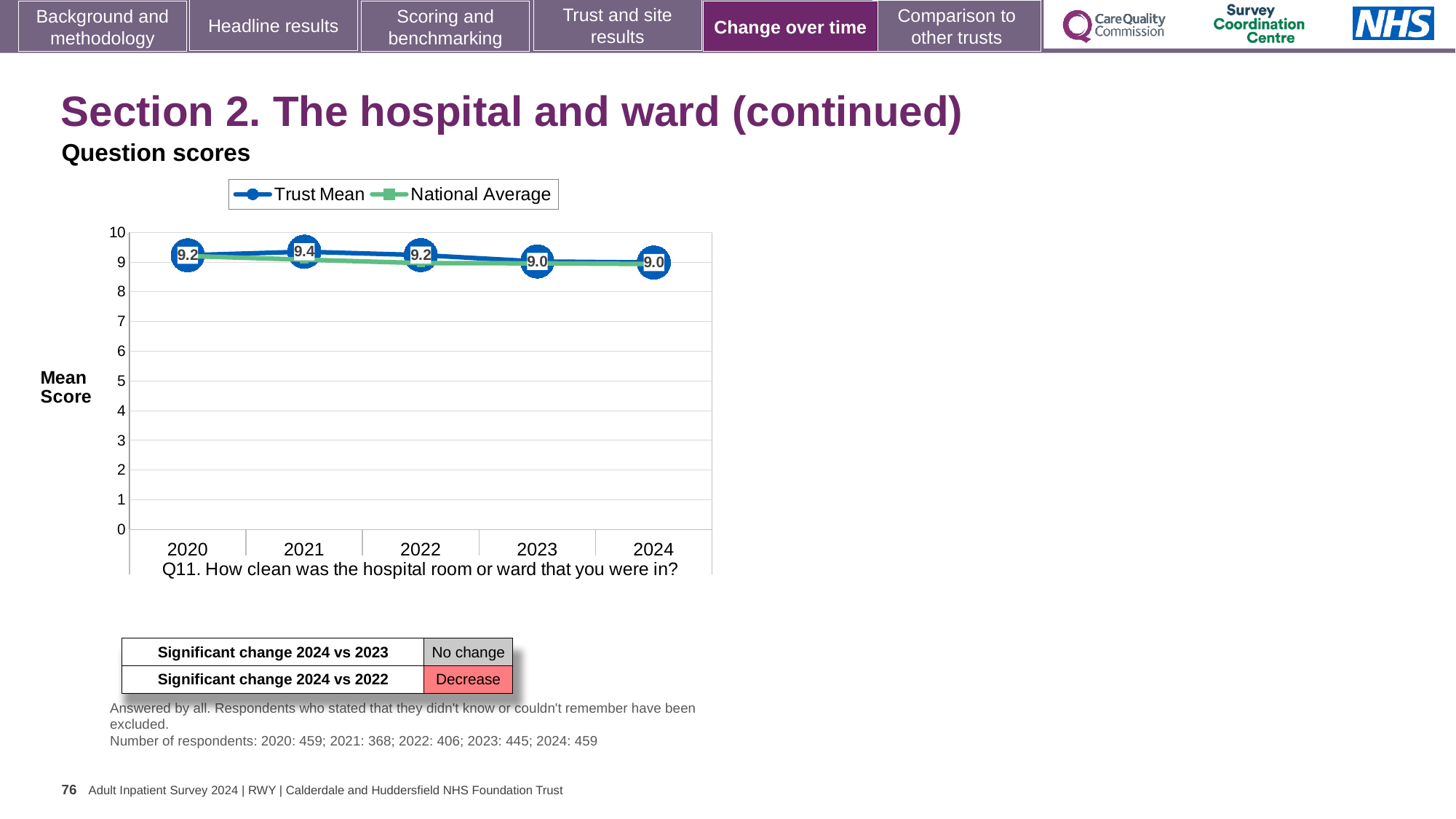
What is the Trust Mean value for 2021? 9.4 Does the Trust Mean rise or fall from 2022 to 2024? fall Which year has the larger Trust Mean, 2021 or 2023? 2021 What is the difference between the Trust Mean in 2021 and in 2024? 0.4 In which year is the Trust Mean highest? 2021 Is the National Average value for 2024 greater or less than 5? greater What is the Trust Mean value for 2024? 9.0 What is the Trust Mean value for 2020? 9.2 What kind of chart is shown on the slide? line chart How many series does the chart legend list? 2 Which survey question does the chart show scores for? Q11. How clean was the hospital room or ward that you were in? How many years are shown on the x axis of the chart? 5